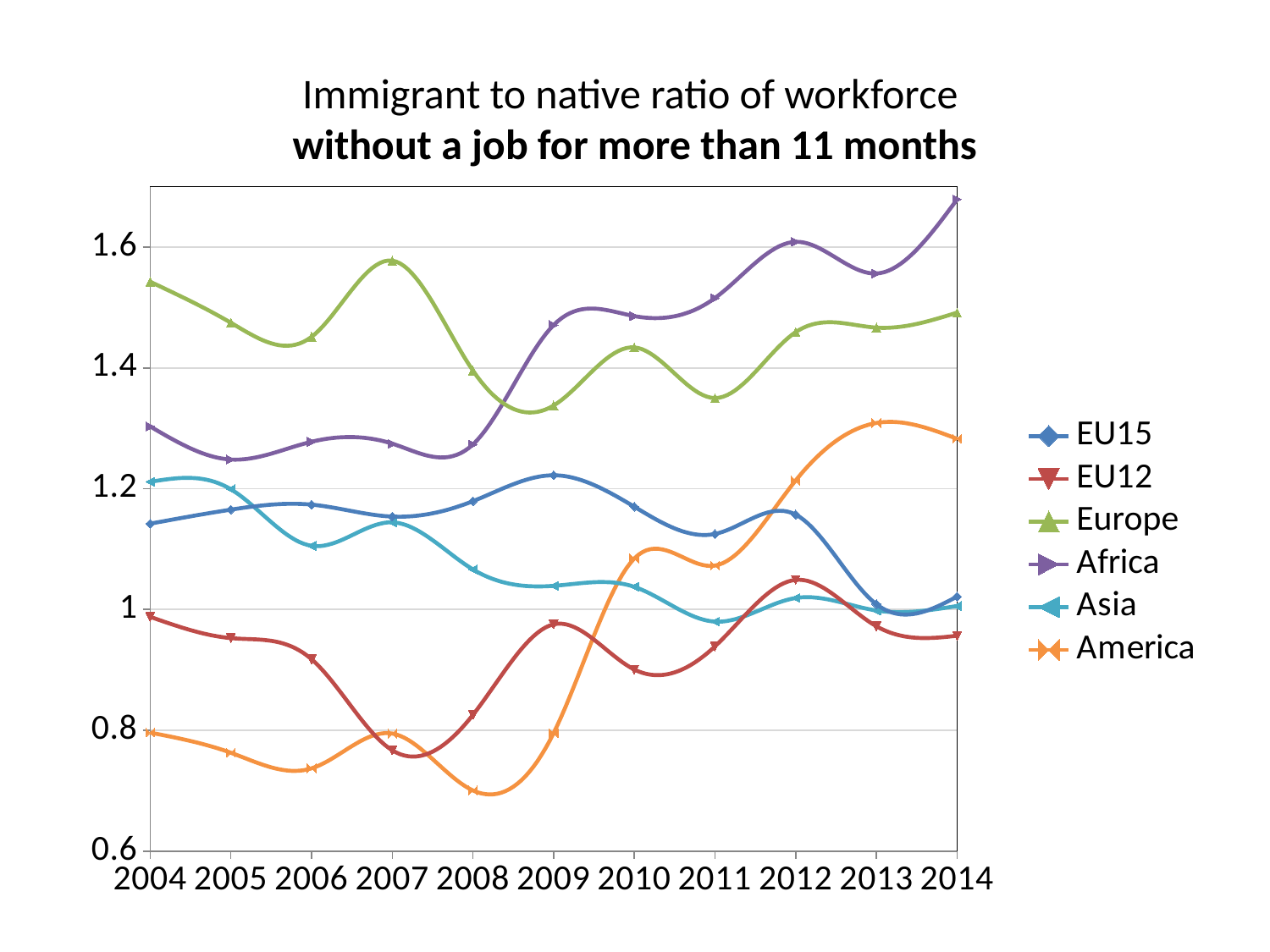
How many series does the legend list? 6 Which is larger in 2012, the value for Africa or the value for Europe? Africa Which series is shown in orange in the legend? America Which series has the lowest value in 2004? America Does the Africa series rise or fall overall from 2004 to 2014? rise What kind of chart is shown on the slide? line chart Which series has the highest value in 2014? Africa How many years are plotted along the x axis? 11 Is the value for America in 2008 greater or less than 0.8? less Which series has the highest value in 2004? Europe Is the value for Europe in 2011 greater or less than 1.4? less Is the value for Africa in 2014 greater or less than 1.6? greater